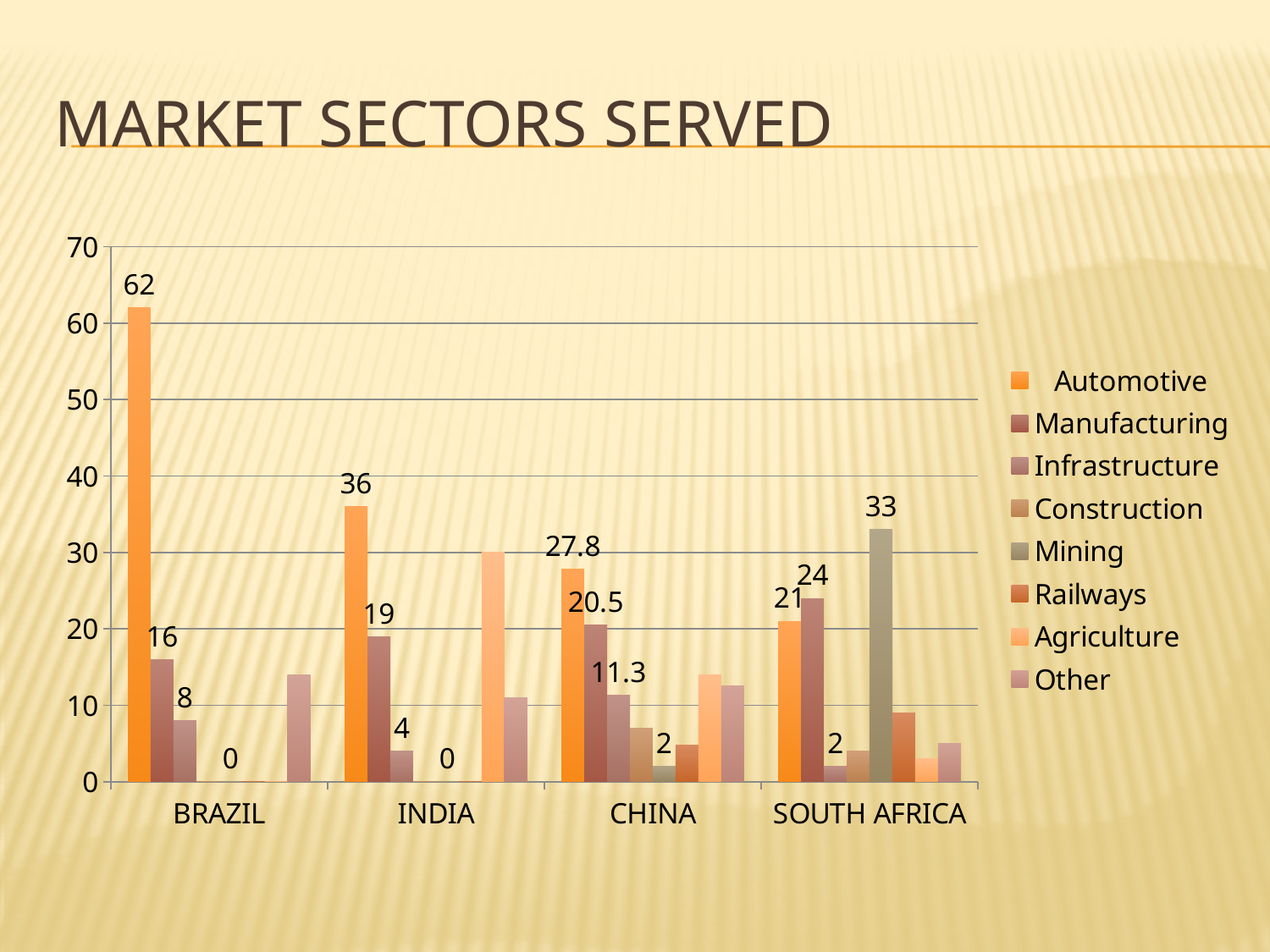
What kind of chart is shown on the slide? bar chart What is the value for Automotive in BRAZIL? 62 Is the value for Agriculture in INDIA greater or less than 20? greater What is the value for Infrastructure in INDIA? 4 In SOUTH AFRICA, which is larger: Automotive or Manufacturing? Manufacturing Do the Automotive values rise or fall from BRAZIL to SOUTH AFRICA along the x axis? fall What is the value for Automotive in CHINA? 27.8 How many countries are shown on the x axis? 4 What is the value for Mining in SOUTH AFRICA? 33 What is the difference between the Automotive values for BRAZIL and INDIA? 26 Which country has the highest Automotive value? BRAZIL How many series does the legend list? 8